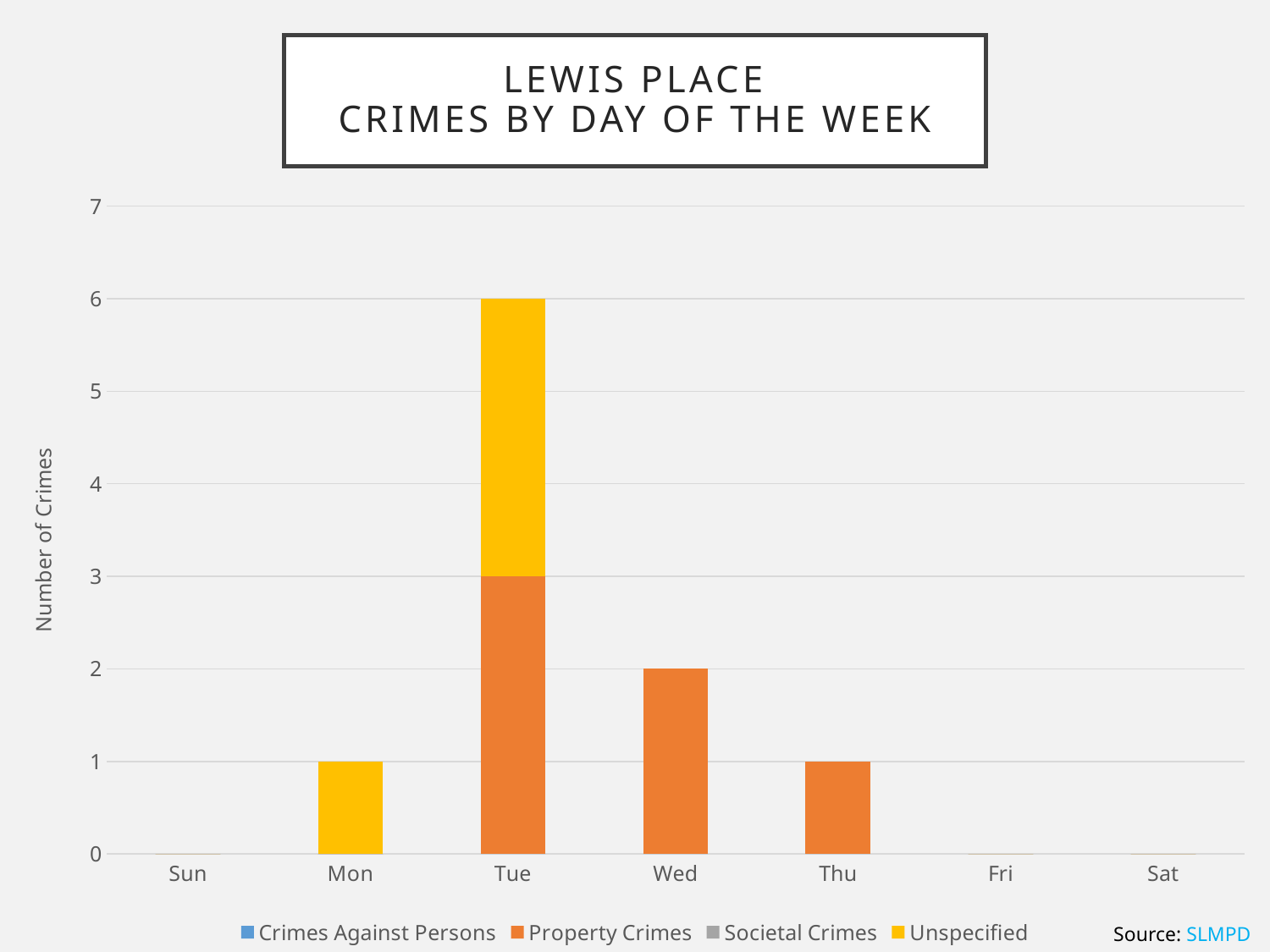
How many Property Crimes are shown for Thu? 1 Which day has the highest total number of crimes? Tue What is the total number of crimes on Tue? 6 How many series does the legend list? 4 What is the difference between the total crimes on Tue and the total crimes on Wed? 4 How many Property Crimes are shown for Wed? 2 How many Property Crimes are shown for Tue? 3 How many days of the week are shown on the x axis? 7 Which has more Property Crimes, Wed or Thu? Wed What type of chart is shown on the slide? Stacked bar chart How many Unspecified crimes are shown for Mon? 1 What is the title of the chart? Lewis Place Crimes by Day of the Week